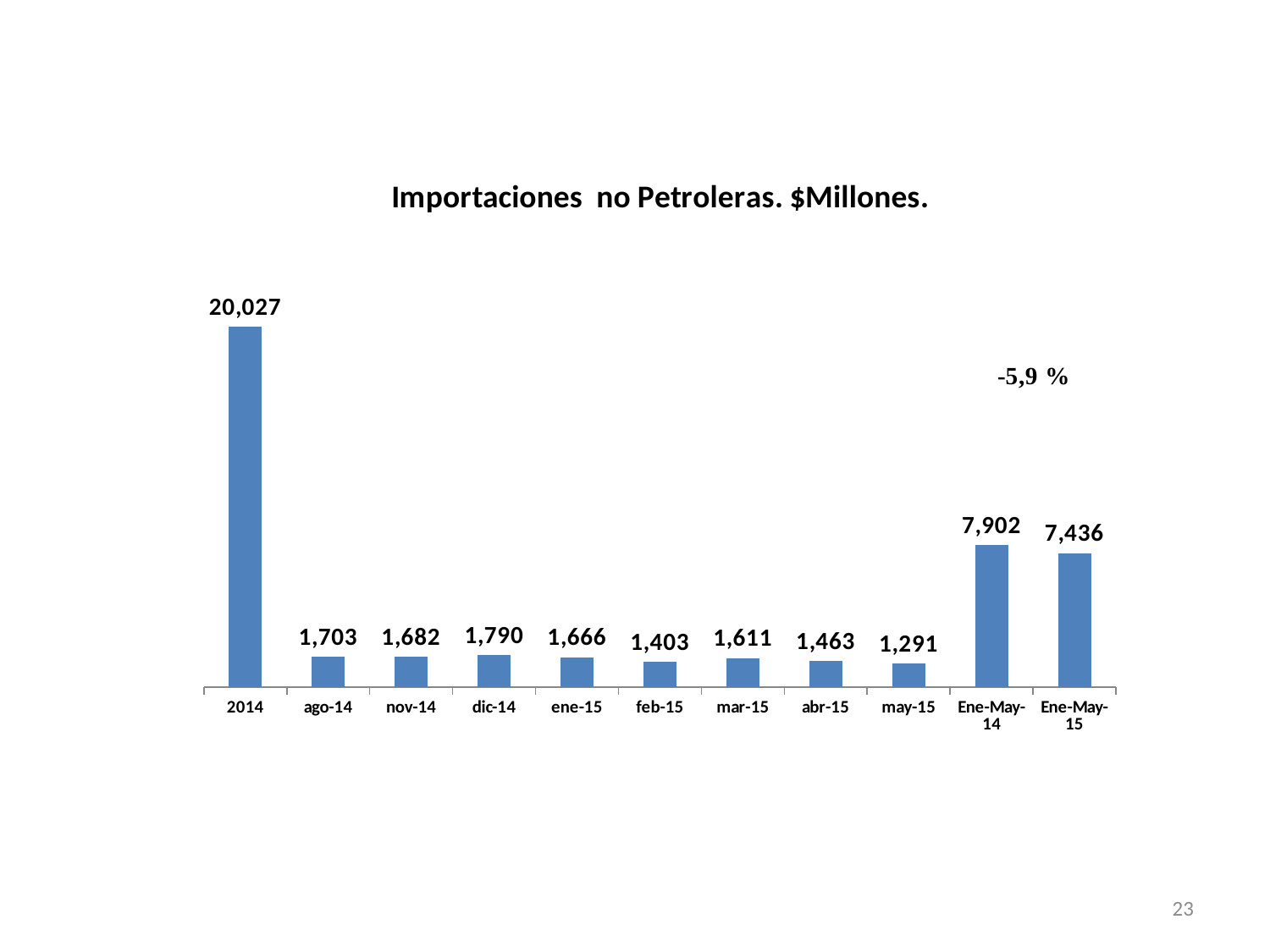
What is the difference between dic-14 and ene-15? 124 What is the value for Ene-May-15? 7,436 Which is larger, the value for mar-15 or the value for abr-15? mar-15 What is the value for dic-14? 1,790 What is the difference between Ene-May-14 and Ene-May-15? 466 Which category has the highest value? 2014 Which category has the lowest value? may-15 What kind of chart is this? bar chart How many categories are shown on the x axis? 11 What is the value for 2014? 20,027 What is the value for may-15? 1,291 What is the title of the chart? Importaciones no Petroleras. $Millones.